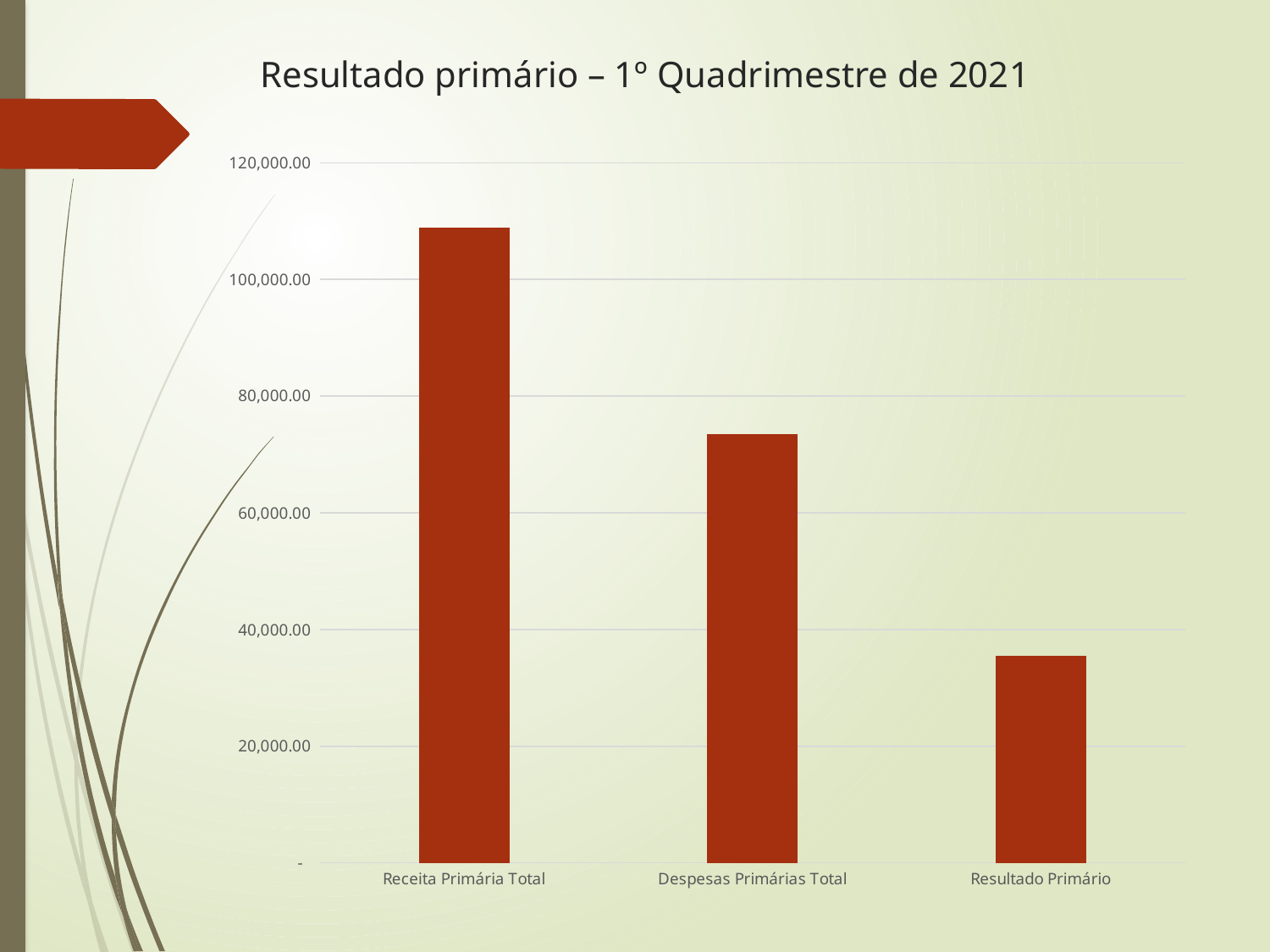
Is the value for Despesas Primárias Total greater or less than 60,000.00? greater Is the value for Resultado Primário greater or less than 40,000.00? less Do the bar values rise or fall from left to right across the categories? fall What is the title of the chart? Resultado primário – 1º Quadrimestre de 2021 How many categories are plotted in the chart? 3 Which category has the highest bar? Receita Primária Total Which is larger, Despesas Primárias Total or Resultado Primário? Despesas Primárias Total Is the value for Receita Primária Total greater or less than 100,000.00? greater What kind of chart is shown on the slide? bar chart Which category has the lowest bar? Resultado Primário Which is larger, Receita Primária Total or Despesas Primárias Total? Receita Primária Total